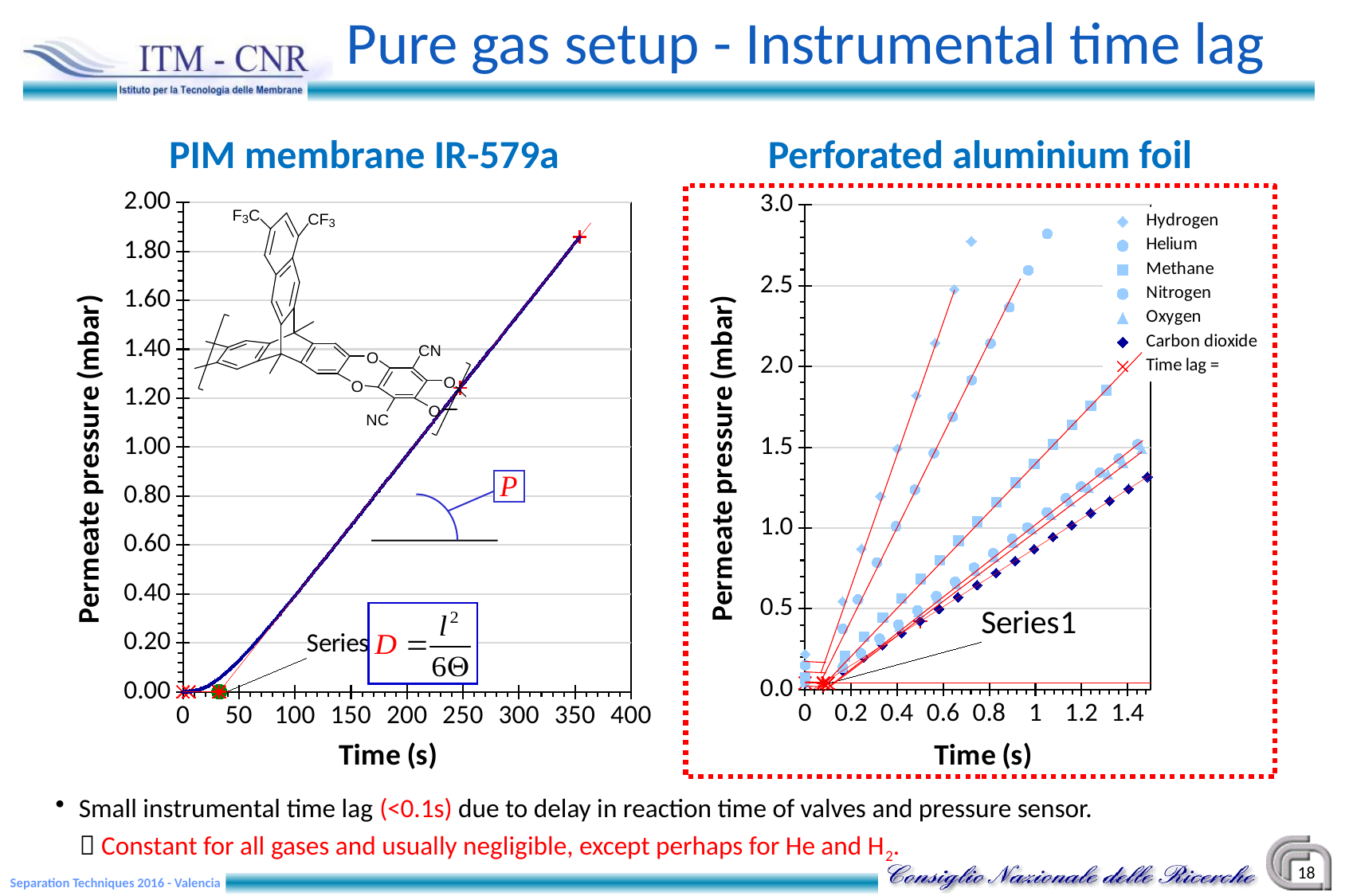
In the 'Perforated aluminium foil' chart, at 0.6 s, which has the higher permeate pressure: Hydrogen or Carbon dioxide? Hydrogen In the 'Perforated aluminium foil' chart, which gas reaches the highest permeate pressure in the shortest time? Hydrogen In the 'Perforated aluminium foil' chart, what is the x-axis title? Time (s) What kind of chart is the 'PIM membrane IR-579a' chart on the left? scatter (line) chart In the 'PIM membrane IR-579a' chart, what is the y-axis title? Permeate pressure (mbar) In the 'Perforated aluminium foil' chart, how many entries does the legend list? 7 In the 'PIM membrane IR-579a' chart, does the permeate pressure rise or fall as time increases? rise In the 'PIM membrane IR-579a' chart, is the permeate pressure at 100 s greater or less than 0.60 mbar? less What kind of chart is the 'Perforated aluminium foil' chart on the right? scatter chart In the 'Perforated aluminium foil' chart, is the permeate pressure of Hydrogen at 0.6 s greater or less than 2.0 mbar? greater In the 'PIM membrane IR-579a' chart, is the permeate pressure at 250 s greater or less than 1.00 mbar? greater In the 'Perforated aluminium foil' chart, which gas shows the lowest permeate pressure at 1.4 s? Carbon dioxide